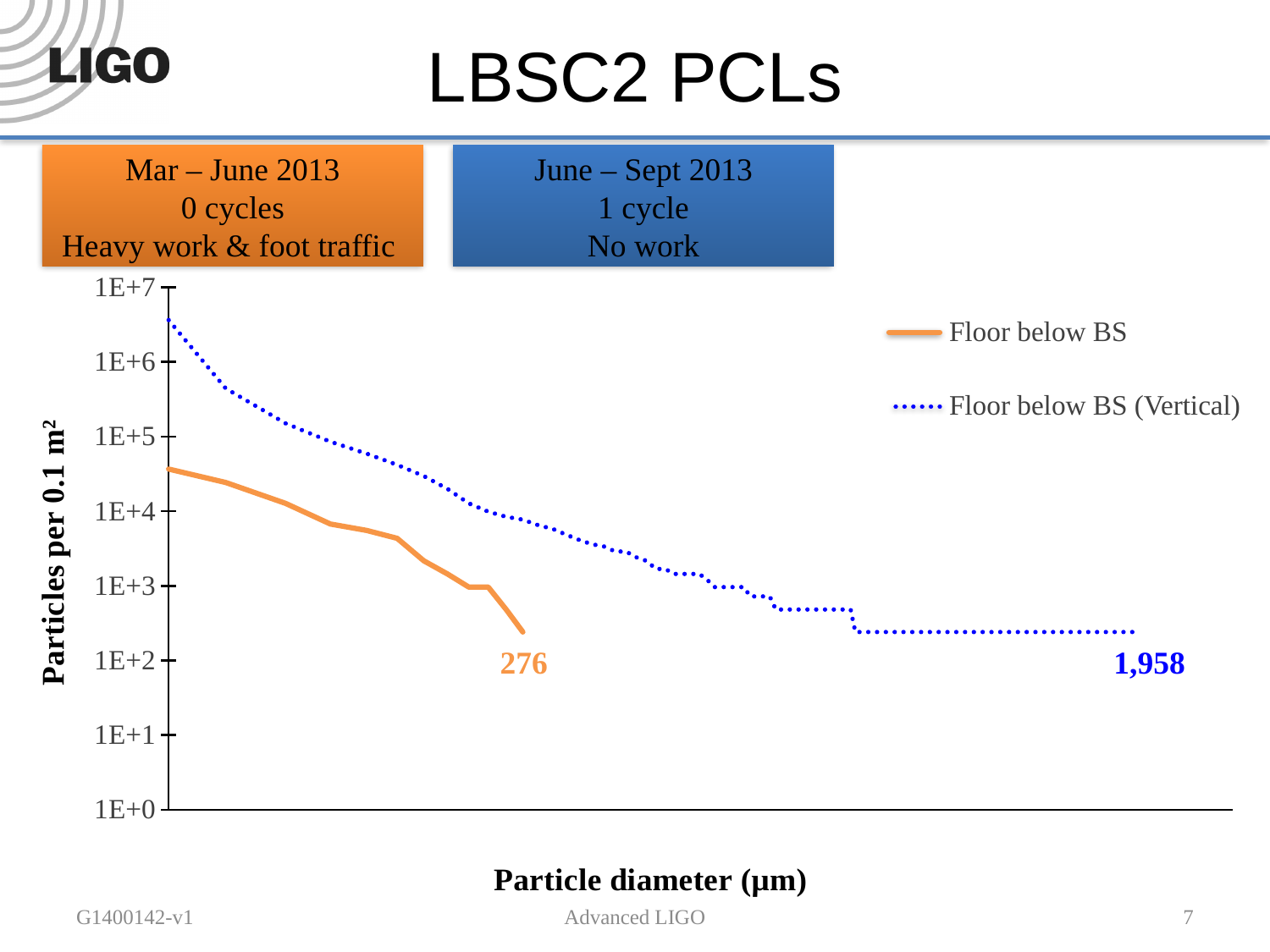
Do the values of the Floor below BS (Vertical) series rise or fall along the x axis? fall What kind of chart is shown on the slide? line chart Which series extends further to the right along the particle diameter axis? Floor below BS (Vertical) Is the starting value of the Floor below BS series at the left of the chart greater or less than 1E+5? less Is the starting value of the Floor below BS series at the left of the chart greater or less than 1E+4? greater Is the value at the right end of the Floor below BS (Vertical) series greater or less than 1E+3? less Do the values of the Floor below BS series rise or fall as particle diameter increases along the x axis? fall How many series does the legend list? 2 Which series has the higher values at the left edge of the chart, Floor below BS or Floor below BS (Vertical)? Floor below BS (Vertical) What number is printed near the end of the orange Floor below BS line? 276 What number is printed near the end of the blue dotted Floor below BS (Vertical) line? 1,958